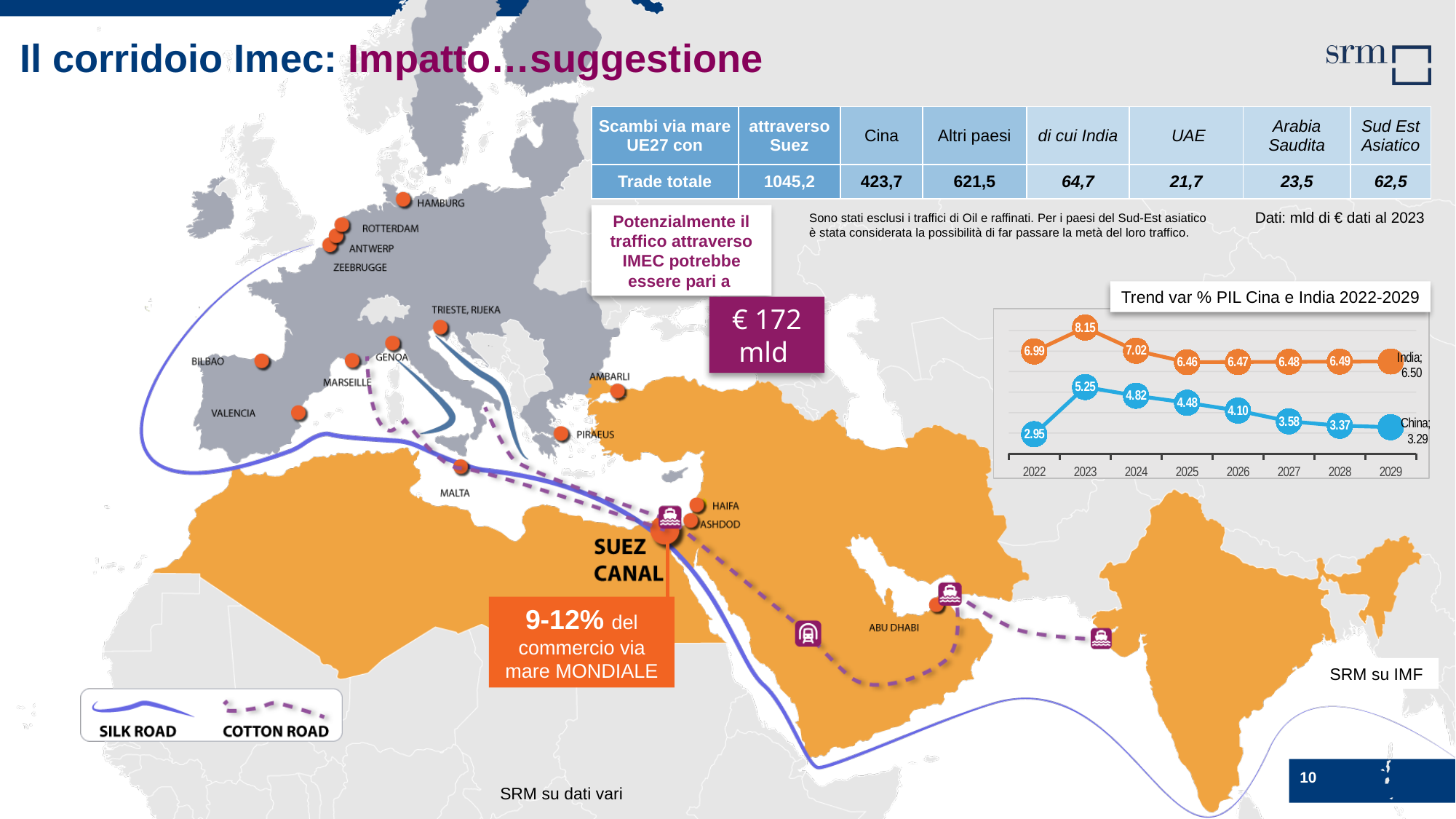
In the chart 'Trend var % PIL Cina e India 2022-2029', do China's values rise or fall from 2023 to 2029? fall In the chart 'Trend var % PIL Cina e India 2022-2029', what is the value for China in 2029? 3.29 What is the title of the line chart on the right of the slide? Trend var % PIL Cina e India 2022-2029 In the chart 'Trend var % PIL Cina e India 2022-2029', how many years are shown on the x axis? 8 In the chart 'Trend var % PIL Cina e India 2022-2029', what is the difference between India's and China's values in 2023? 2.90 In the chart 'Trend var % PIL Cina e India 2022-2029', what is the value for China in 2022? 2.95 In the chart 'Trend var % PIL Cina e India 2022-2029', what type of chart is shown? line chart In the chart 'Trend var % PIL Cina e India 2022-2029', in which year does China have its lowest value? 2022 In the chart 'Trend var % PIL Cina e India 2022-2029', what is the value for India in 2023? 8.15 In the chart 'Trend var % PIL Cina e India 2022-2029', which series has the higher value in 2026, India or China? India In the chart 'Trend var % PIL Cina e India 2022-2029', how many series are plotted? 2 In the chart 'Trend var % PIL Cina e India 2022-2029', in which year does India reach its highest value? 2023